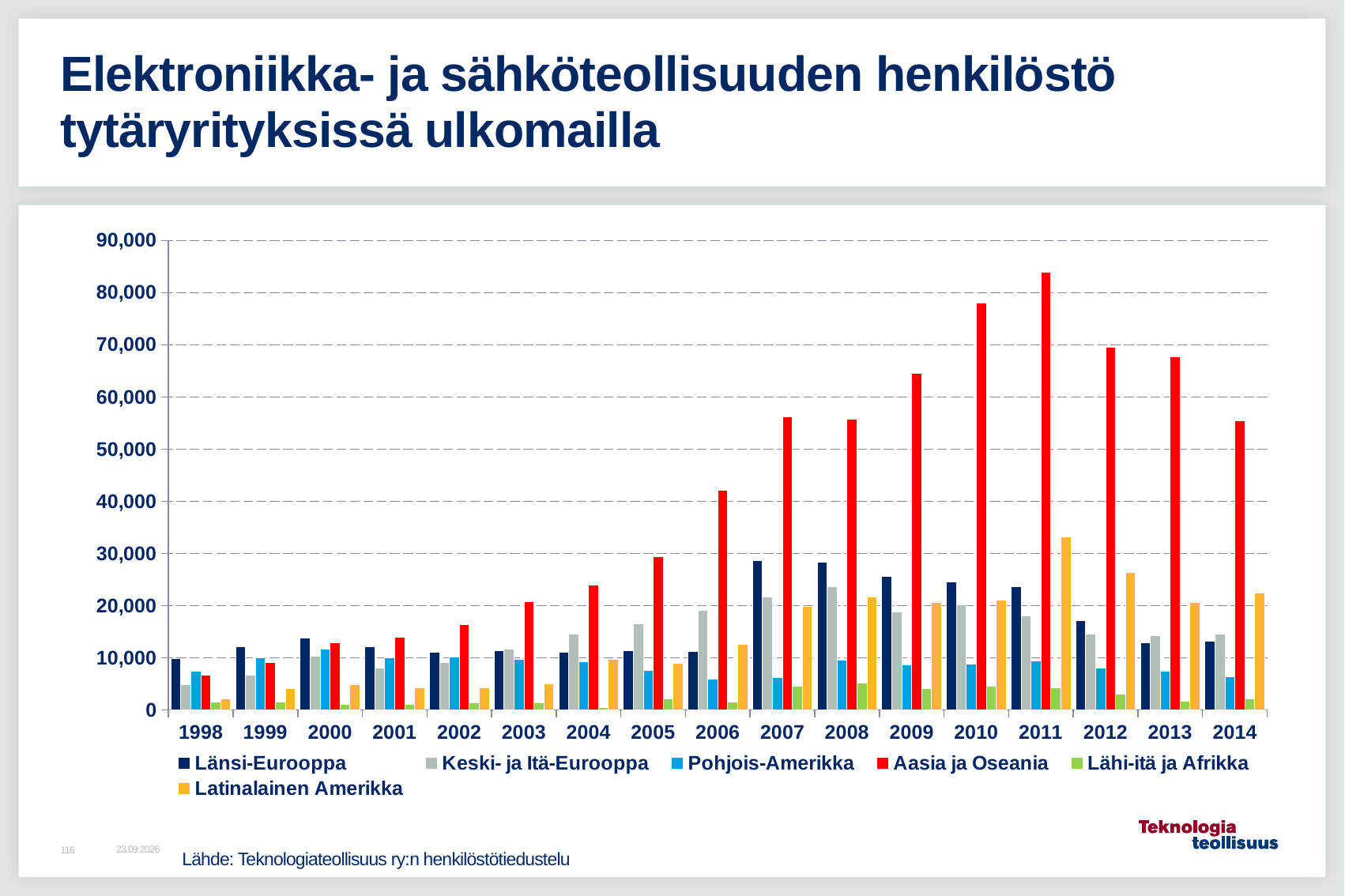
How many series does the legend list? 6 Which is larger in 2012, the value for Länsi-Eurooppa or for Keski- ja Itä-Eurooppa? Länsi-Eurooppa In which year is the value for Aasia ja Oseania highest? 2011 Which is larger, the value for Aasia ja Oseania in 2010 or in 2012? 2010 What kind of chart is shown on the slide? bar chart Is the value for Aasia ja Oseania in 2011 greater or less than 80,000? greater What colour are the bars for Aasia ja Oseania? red Does the value for Aasia ja Oseania rise or fall from 1998 to 2011? rise Is the value for Aasia ja Oseania in 2006 greater or less than 40,000? greater How many years are shown on the x axis? 17 Which series has the lowest value in 2014? Lähi-itä ja Afrikka Is the value for Latinalainen Amerikka in 2011 greater or less than 30,000? greater